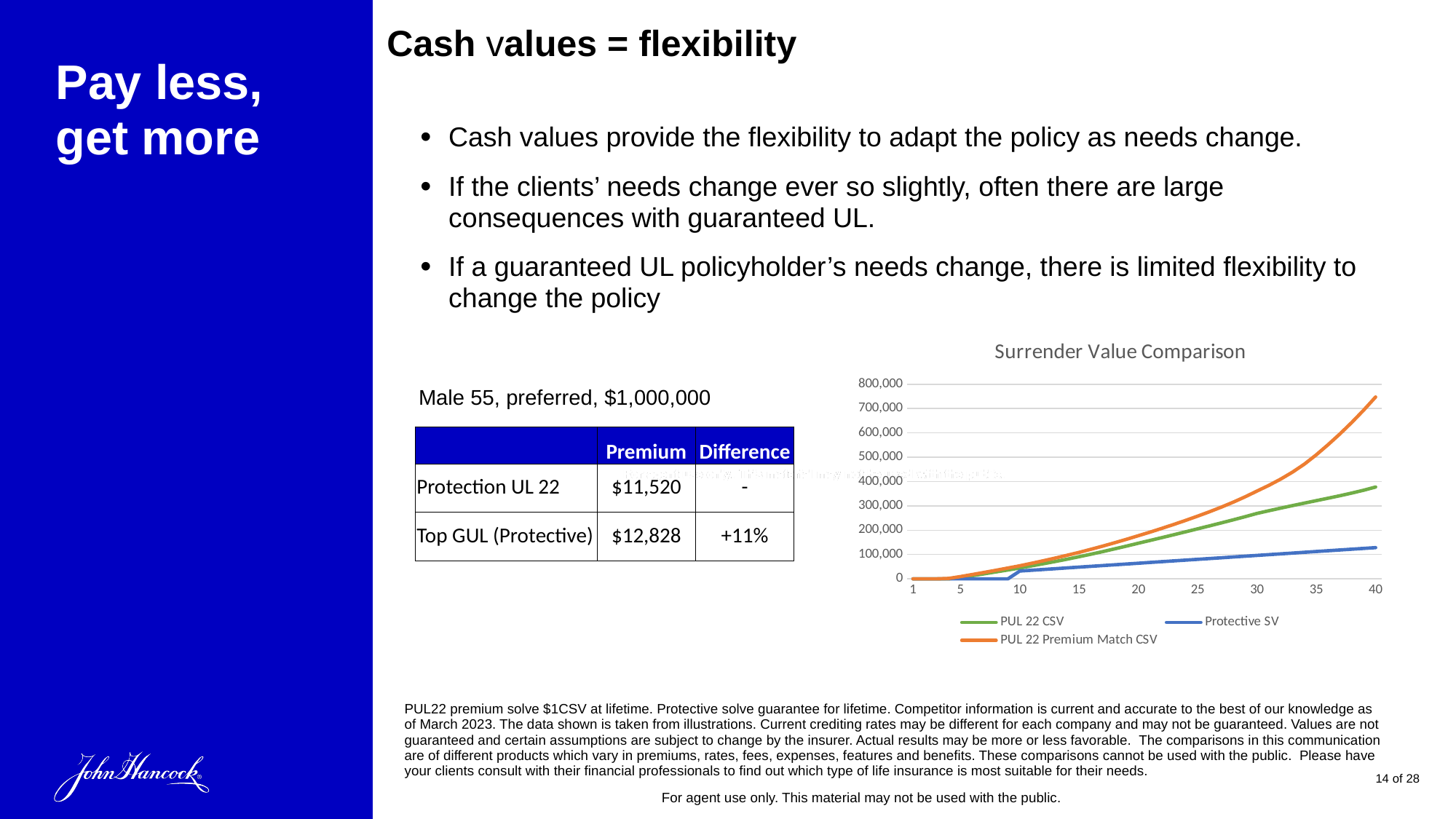
In the Surrender Value Comparison chart, is the PUL 22 CSV value at year 40 greater or less than 400,000? less In the Surrender Value Comparison chart, does the PUL 22 Premium Match CSV series rise or fall as the years increase? rise In the Surrender Value Comparison chart, is the PUL 22 Premium Match CSV value at year 40 greater or less than 700,000? greater In the Surrender Value Comparison chart, which series has the highest value at year 40? PUL 22 Premium Match CSV How many series does the legend of the Surrender Value Comparison chart list? 3 In the Surrender Value Comparison chart, which series is drawn in orange? PUL 22 Premium Match CSV In the Surrender Value Comparison chart, at year 40, which is larger: PUL 22 CSV or Protective SV? PUL 22 CSV What type of chart is the Surrender Value Comparison chart? line chart In the Surrender Value Comparison chart, which series has the lowest value at year 40? Protective SV In the Surrender Value Comparison chart, is the PUL 22 CSV value at year 30 greater or less than 300,000? less What is the title of the chart on the slide? Surrender Value Comparison